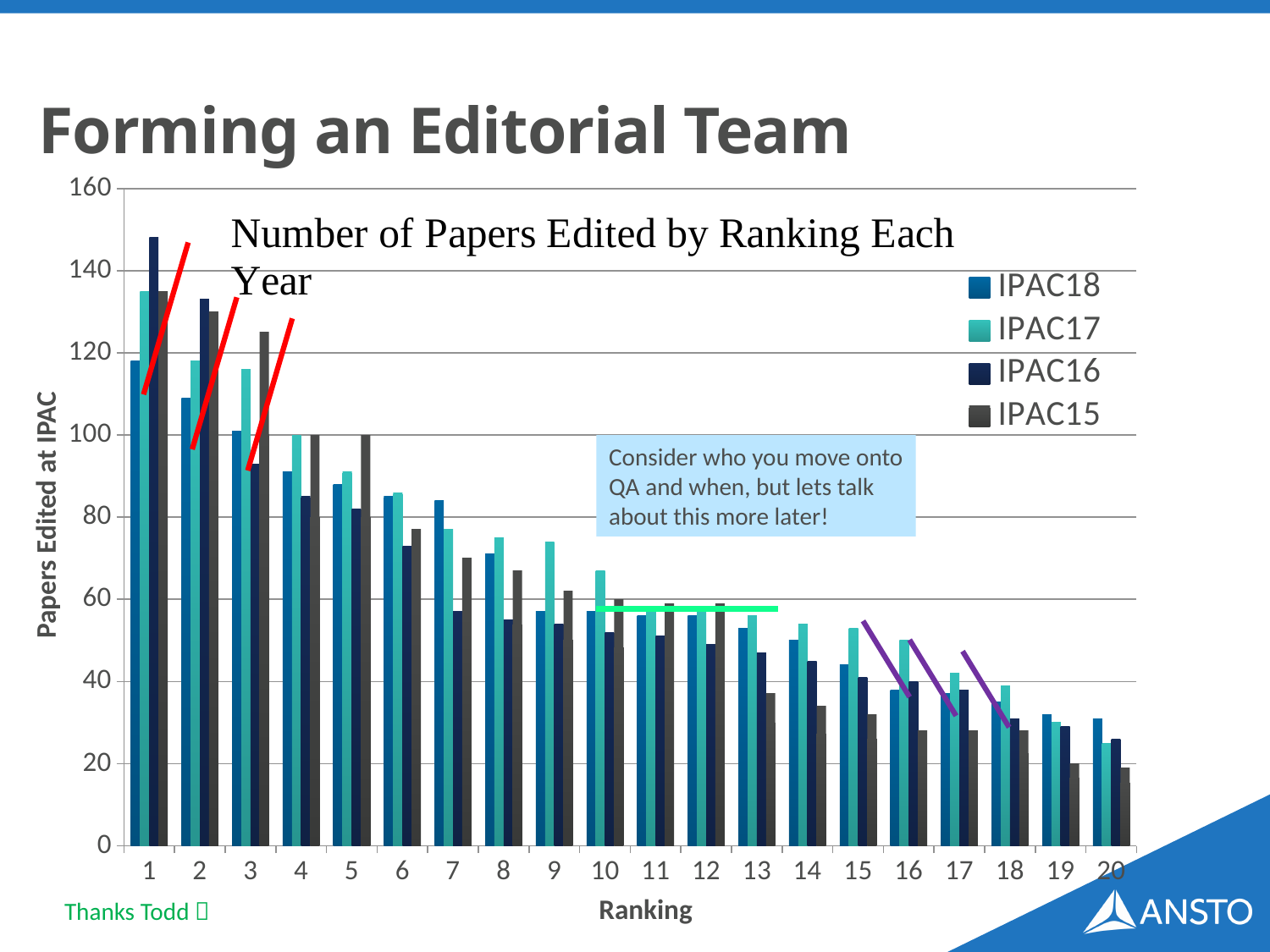
How many series does the legend list? 4 What is the label on the vertical axis? Papers Edited at IPAC Is the IPAC16 value for ranking 1 greater or less than 140? greater What kind of chart is shown on the slide? bar chart What is the title of the chart? Number of Papers Edited by Ranking Each Year Which series has the highest value at ranking 1? IPAC16 Is the IPAC18 value for ranking 1 greater or less than 100? greater How many ranking categories are shown on the x axis? 20 Is the IPAC15 value for ranking 15 greater or less than 40? less At ranking 3, which is larger, the IPAC15 value or the IPAC16 value? IPAC15 Do the IPAC18 values generally rise or fall as the ranking increases from 1 to 20? fall At ranking 7, which is larger, the IPAC18 value or the IPAC16 value? IPAC18